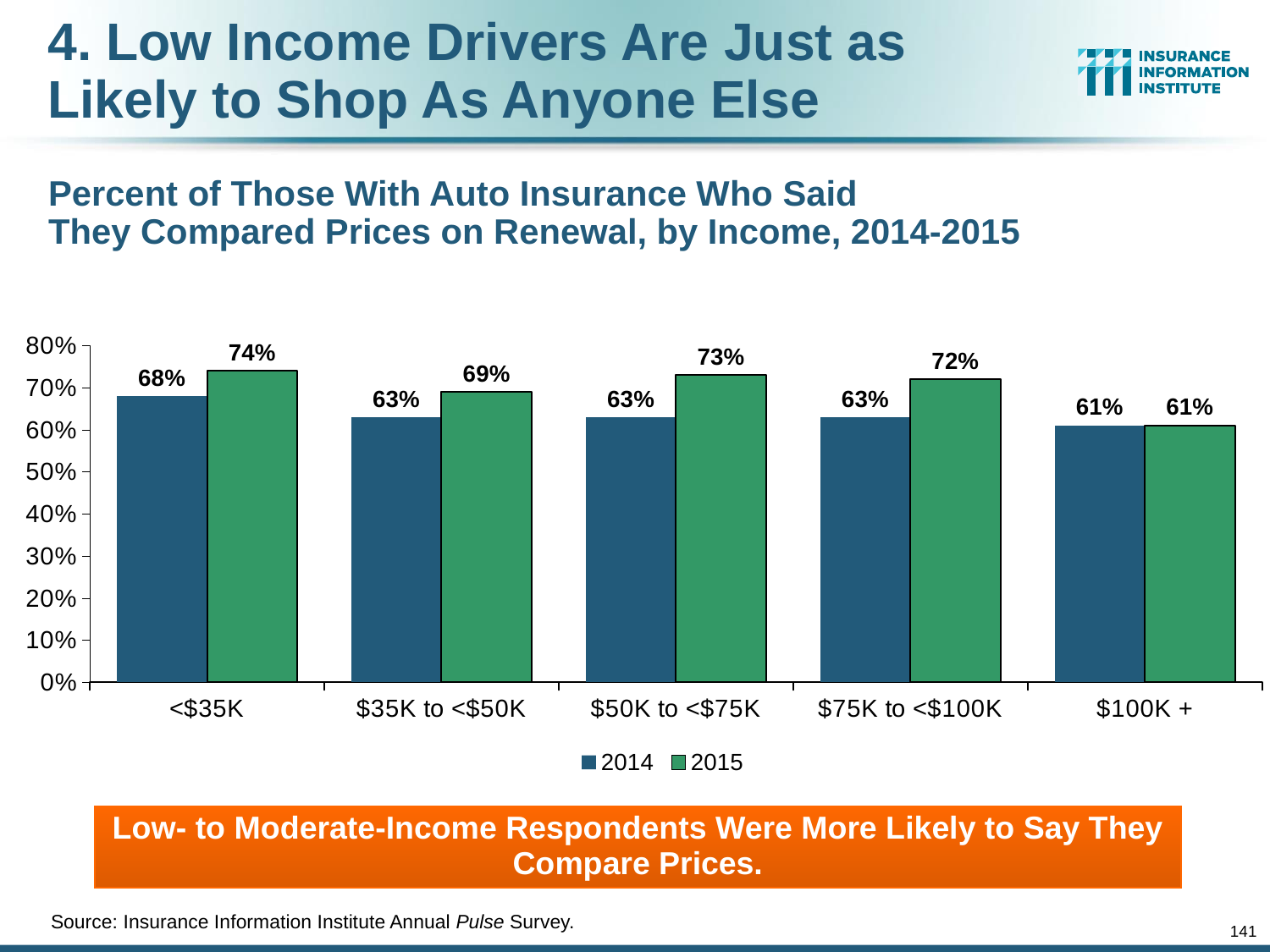
What kind of chart is shown on the slide? Bar chart Which is larger for the $50K to <$75K group, the 2014 value or the 2015 value? 2015 What was the 2014 value for the $75K to <$100K income group? 63% What percentage of respondents with income <$35K said they compared prices on renewal in 2015? 74% What is the difference between the 2015 values for <$35K and $100K +? 13 percentage points How many series does the legend list? 2 What is the difference between the 2015 and 2014 values for the $35K to <$50K group? 6 percentage points How many income groups are shown on the x axis? 5 What was the 2015 value for the $100K + income group? 61% Which series is shown in green in the legend? 2015 Which income group had the highest percentage in 2015? <$35K Which income group had the lowest percentage in 2014? $100K +